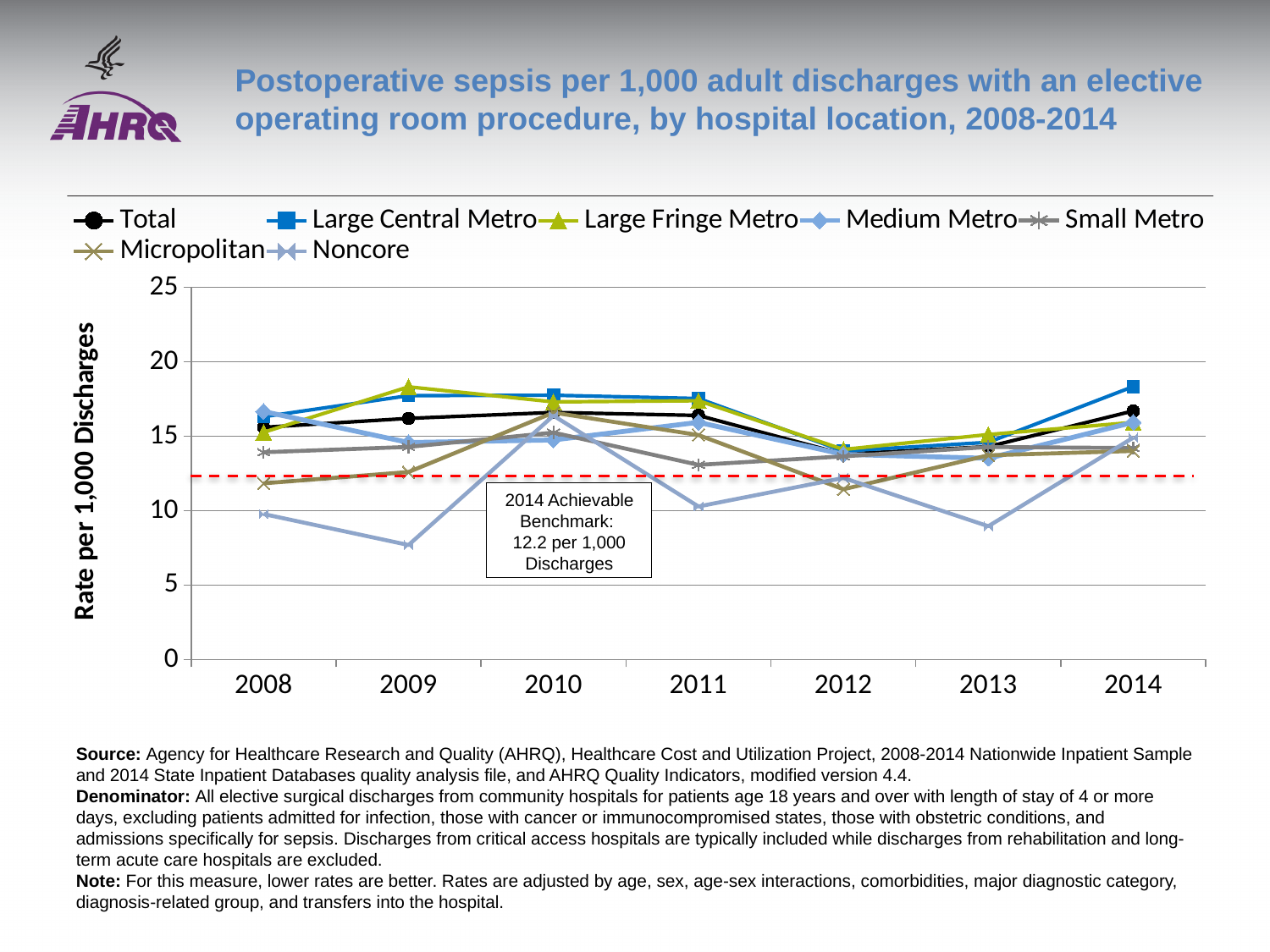
Is the value for Large Central Metro in 2014 greater or less than 15? greater Which series has the lowest value in 2009? Noncore What kind of chart is shown on the slide? line chart Is the value for Noncore in 2013 greater or less than 10? less What is the 2014 achievable benchmark shown on the chart? 12.2 per 1,000 Discharges Which is larger for Noncore: the value in 2009 or the value in 2010? 2010 Is the value for Noncore in 2009 greater or less than 10? less Does the Total series rise or fall from 2011 to 2012? fall Which series has the highest value in 2014? Large Central Metro What is the label of the y axis? Rate per 1,000 Discharges How many years are plotted along the x axis? 7 How many series does the legend list? 7